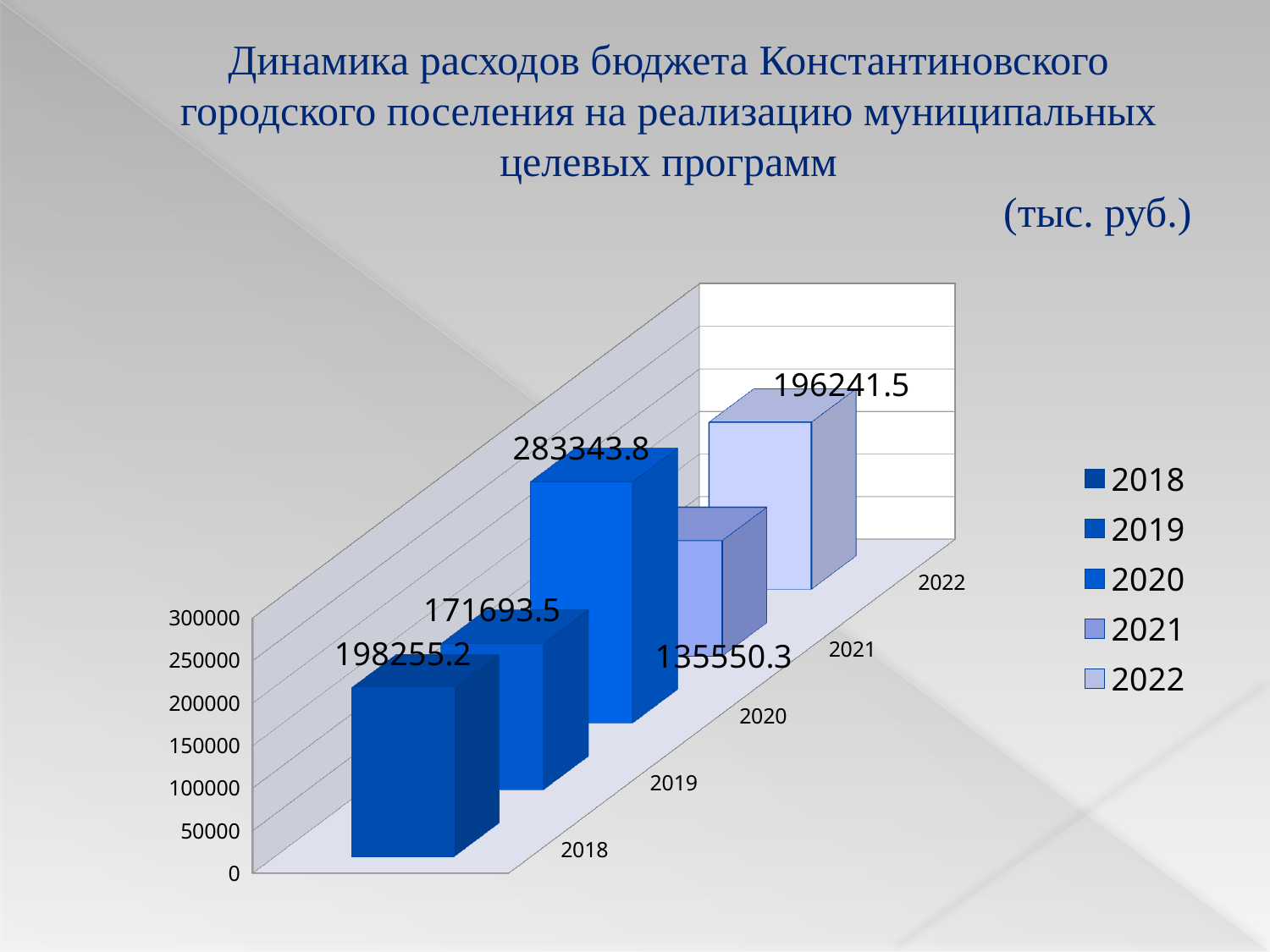
What is the difference between the values for 2018 and 2019? 26561.7 Is the value for 2020 greater or less than 250000? greater Which is larger, the value for 2019 or the value for 2022? 2022 What is the value for 2020? 283343.8 Which year has the highest value? 2020 What is the value for 2022? 196241.5 Which year has the lowest value? 2021 What kind of chart is shown on the slide? bar chart What is the value for 2021? 135550.3 How many years are shown in the chart? 5 What is the value for 2018? 198255.2 What is the difference between the values for 2020 and 2021? 147793.5